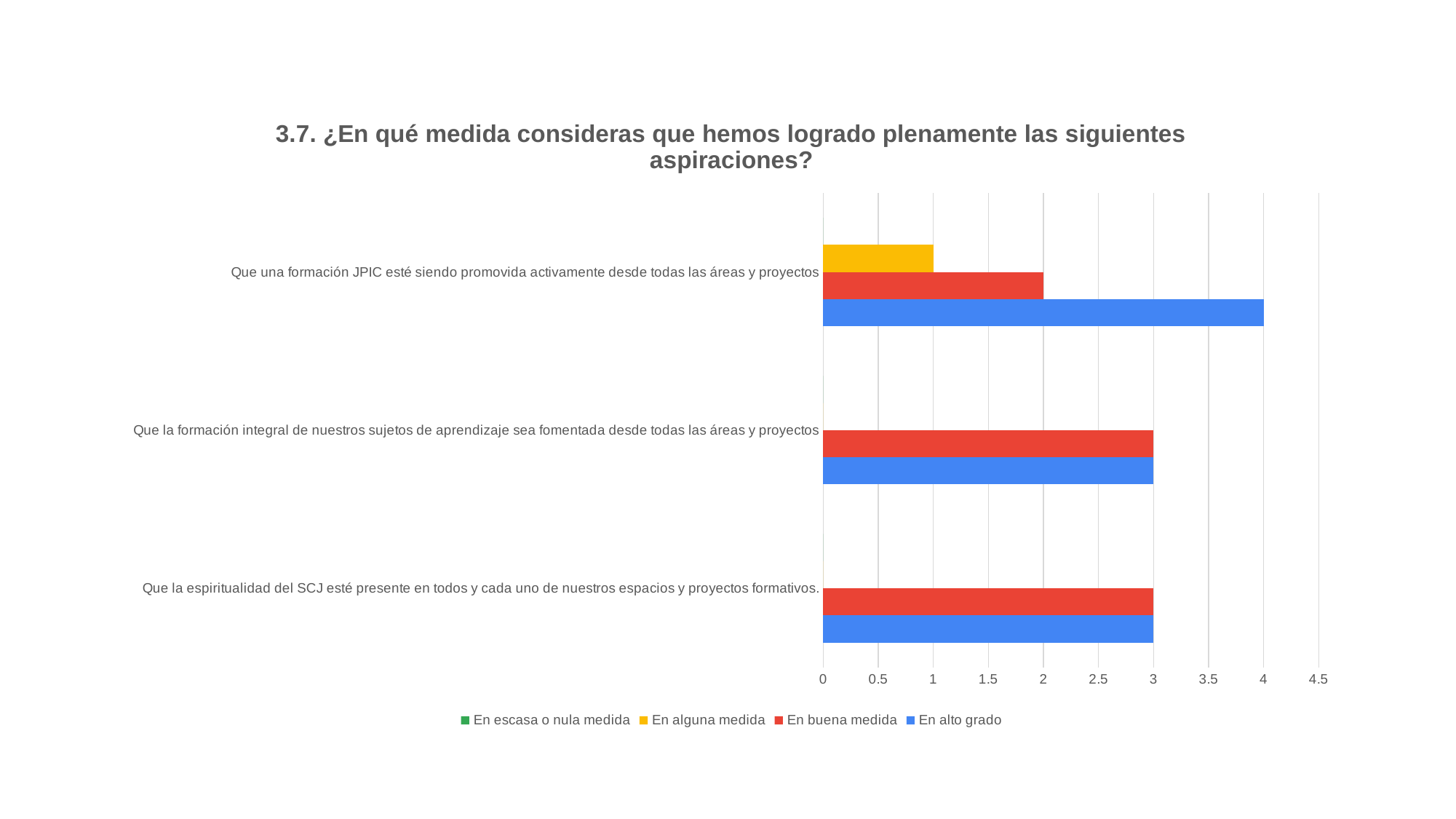
How many series does the legend list? 4 What colour represents 'En alto grado' in the chart? blue Which category is the only one with a bar for 'En alguna medida'? Que una formación JPIC esté siendo promovida activamente desde todas las áreas y proyectos How many categories (aspirations) are plotted on the chart? 3 For 'Que una formación JPIC esté siendo promovida activamente desde todas las áreas y proyectos', which is larger: 'En alto grado' or 'En alguna medida'? En alto grado What is the value of 'En alguna medida' for 'Que una formación JPIC esté siendo promovida activamente desde todas las áreas y proyectos'? 1 What is the value of 'En buena medida' for 'Que una formación JPIC esté siendo promovida activamente desde todas las áreas y proyectos'? 2 What is the value of 'En alto grado' for 'Que una formación JPIC esté siendo promovida activamente desde todas las áreas y proyectos'? 4 What kind of chart is shown on the slide? bar chart What is the value of 'En alto grado' for 'Que la espiritualidad del SCJ esté presente en todos y cada uno de nuestros espacios y proyectos formativos.'? 3 What is the difference between the 'En alto grado' and 'En buena medida' values for 'Que una formación JPIC esté siendo promovida activamente desde todas las áreas y proyectos'? 2 Which category has the highest 'En alto grado' value? Que una formación JPIC esté siendo promovida activamente desde todas las áreas y proyectos